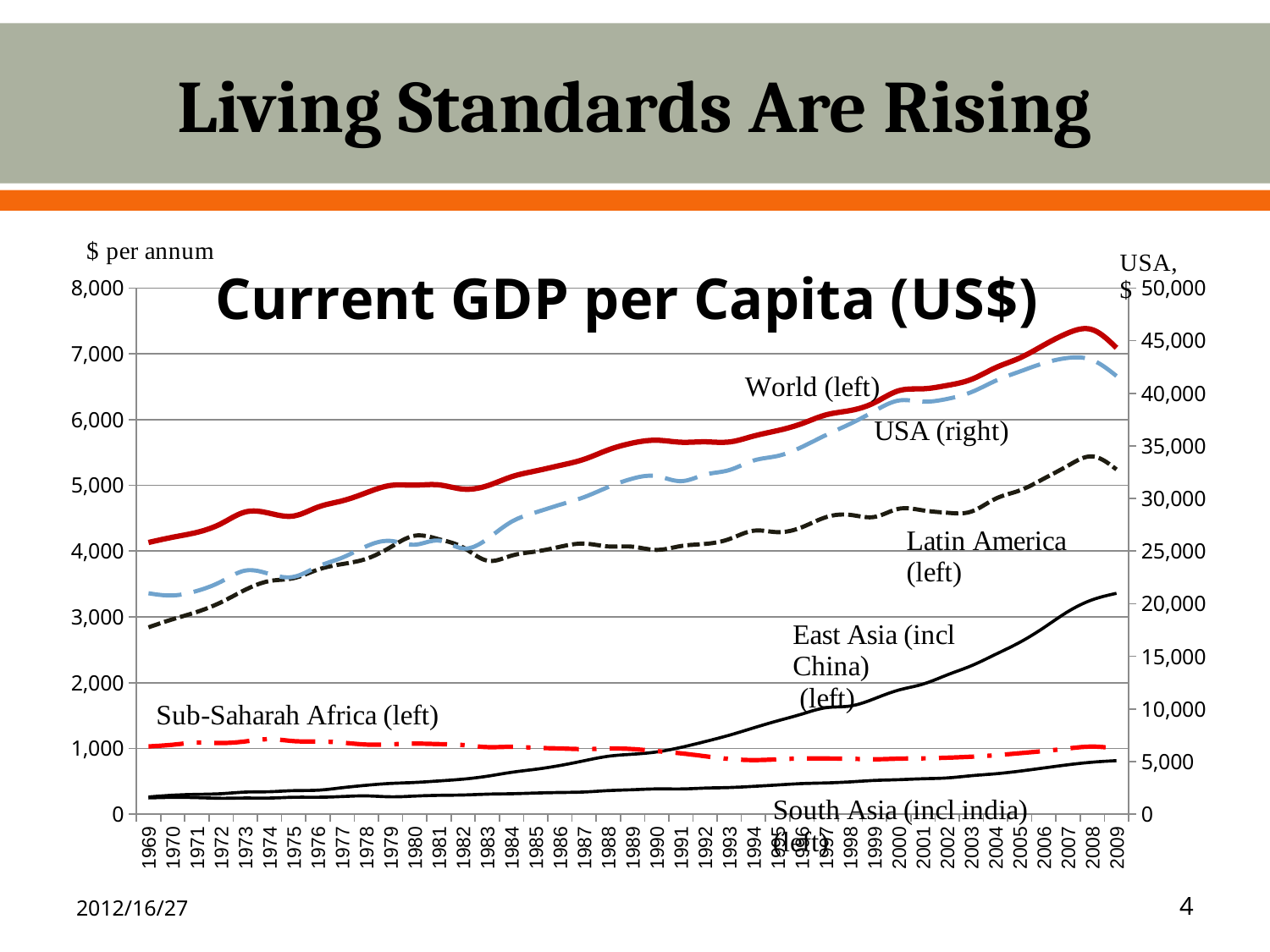
Which series is plotted against the right-hand axis? USA Among the series plotted on the left axis, which has the lowest value in 2009? South Asia (incl india) Is the value for World (left) in 2009 greater or less than 6,000? greater What kind of chart is shown on the slide? line chart Is the value for Sub-Saharah Africa (left) in 2009 greater or less than 2,000? less In 2009, which is higher on the left axis: East Asia (incl China) or South Asia (incl india)? East Asia (incl China) Is the value for Latin America (left) in 1969 greater or less than 4,000? less Does the World (left) series rise or fall from 1969 to 2009? rise What is the title of the chart? Current GDP per Capita (US$) Does the Sub-Saharah Africa (left) series rise or fall between 1980 and 1995? fall How many series are plotted on the chart? 6